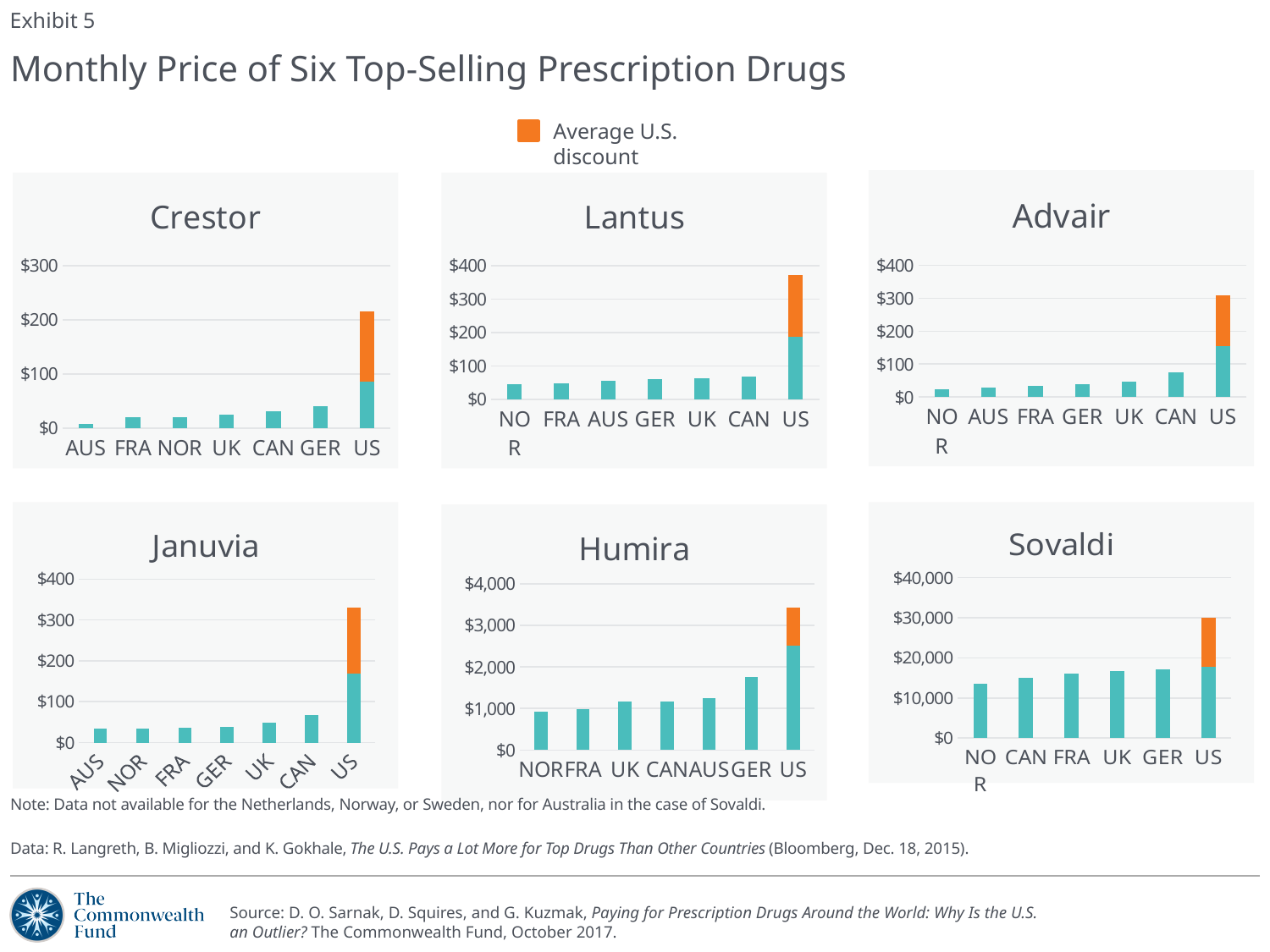
What does the orange colour in the legend represent? Average U.S. discount In the Crestor chart, is the total value for US greater or less than $200? greater In the Humira chart, is the value for GER greater or less than $1,000? greater What kind of chart is the Crestor chart? bar chart In the Crestor chart, which country has the highest monthly price? US In the Januvia chart, which is larger, the value for CAN or the value for UK? CAN In the Lantus chart, is the total value for US greater or less than $300? greater How many charts are on the slide? 6 How many countries are shown in the Sovaldi chart? 6 How many countries are shown in the Lantus chart? 7 In the Crestor chart, which country has the lowest monthly price? AUS